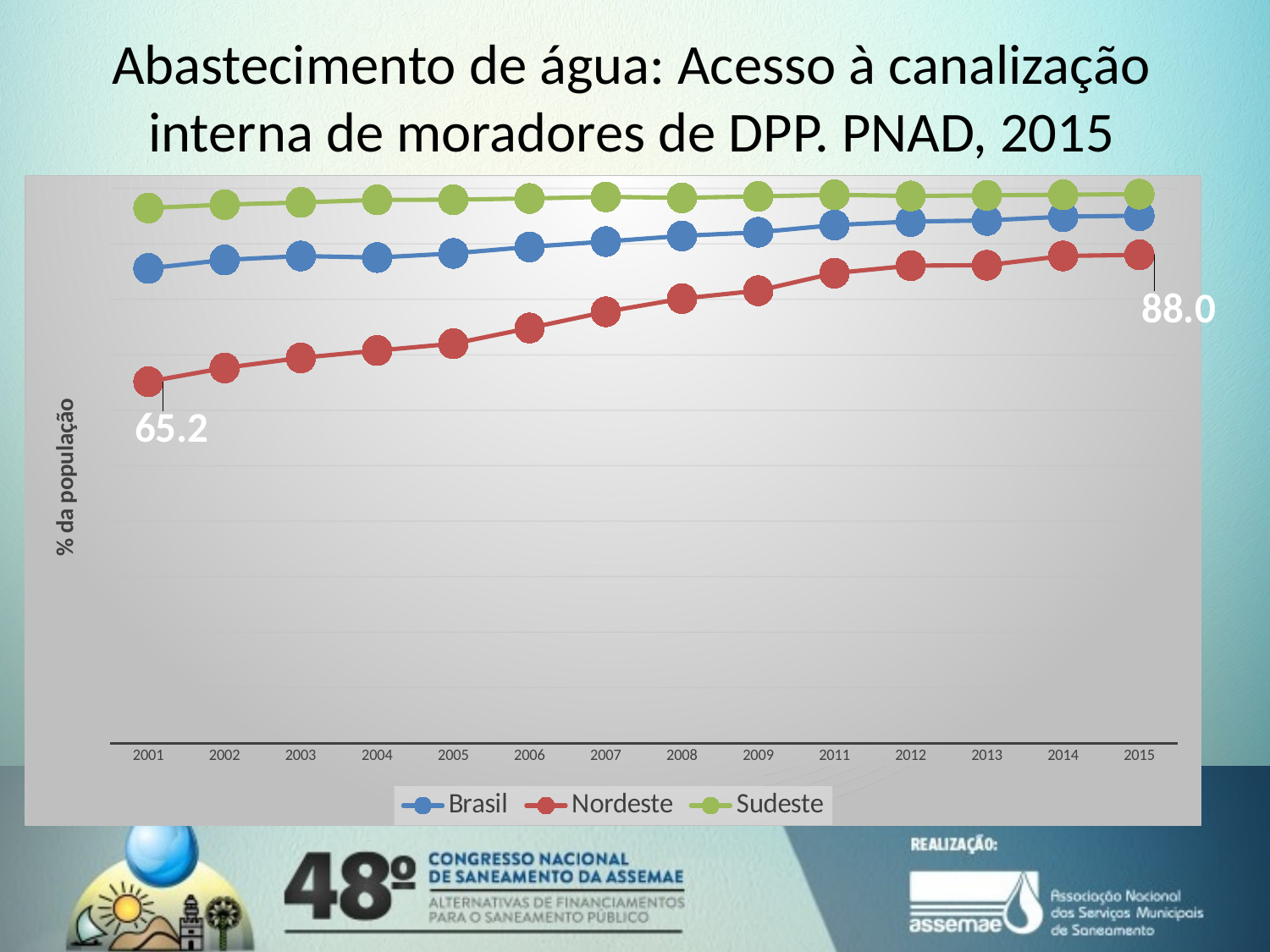
Which series is drawn in red? Nordeste How many series does the legend list? 3 What is the value for Nordeste in 2015? 88.0 What is the value for Nordeste in 2001? 65.2 Which series has the lowest value in 2001? Nordeste In 2008, which is larger: the value for Brasil or the value for Nordeste? Brasil What is the label of the y axis? % da população Does the Nordeste line rise or fall from 2001 to 2015? Rise How many years are shown along the x axis? 14 What kind of chart is shown on the slide? Line chart Which series has the highest value in 2015? Sudeste By how much did the Nordeste value increase from 2001 to 2015? 22.8